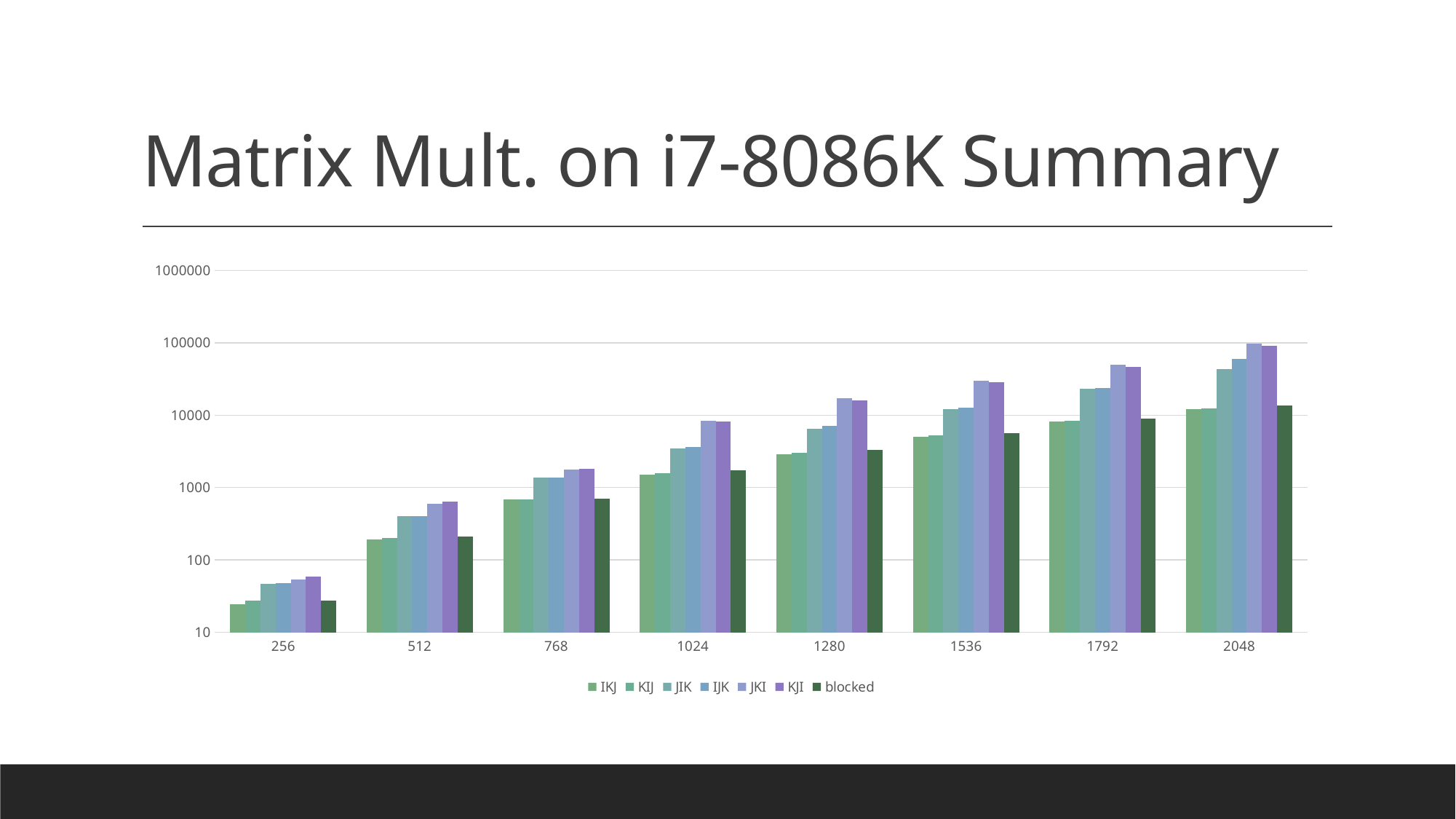
Is the value for IKJ at 768 greater or less than 1000? less Is the value for blocked at 512 greater or less than 100? greater Do the values for the JKI series rise or fall as the x axis goes from 256 to 2048? rise Is the value for blocked at 2048 greater or less than 10000? greater Which is larger at 1024: the value for JKI or the value for blocked? JKI How many series does the legend list? 7 What kind of chart is shown on the slide? bar chart How many categories are shown along the x axis? 8 What is the last series listed in the legend? blocked What is the title of the slide containing the chart? Matrix Mult. on i7-8086K Summary